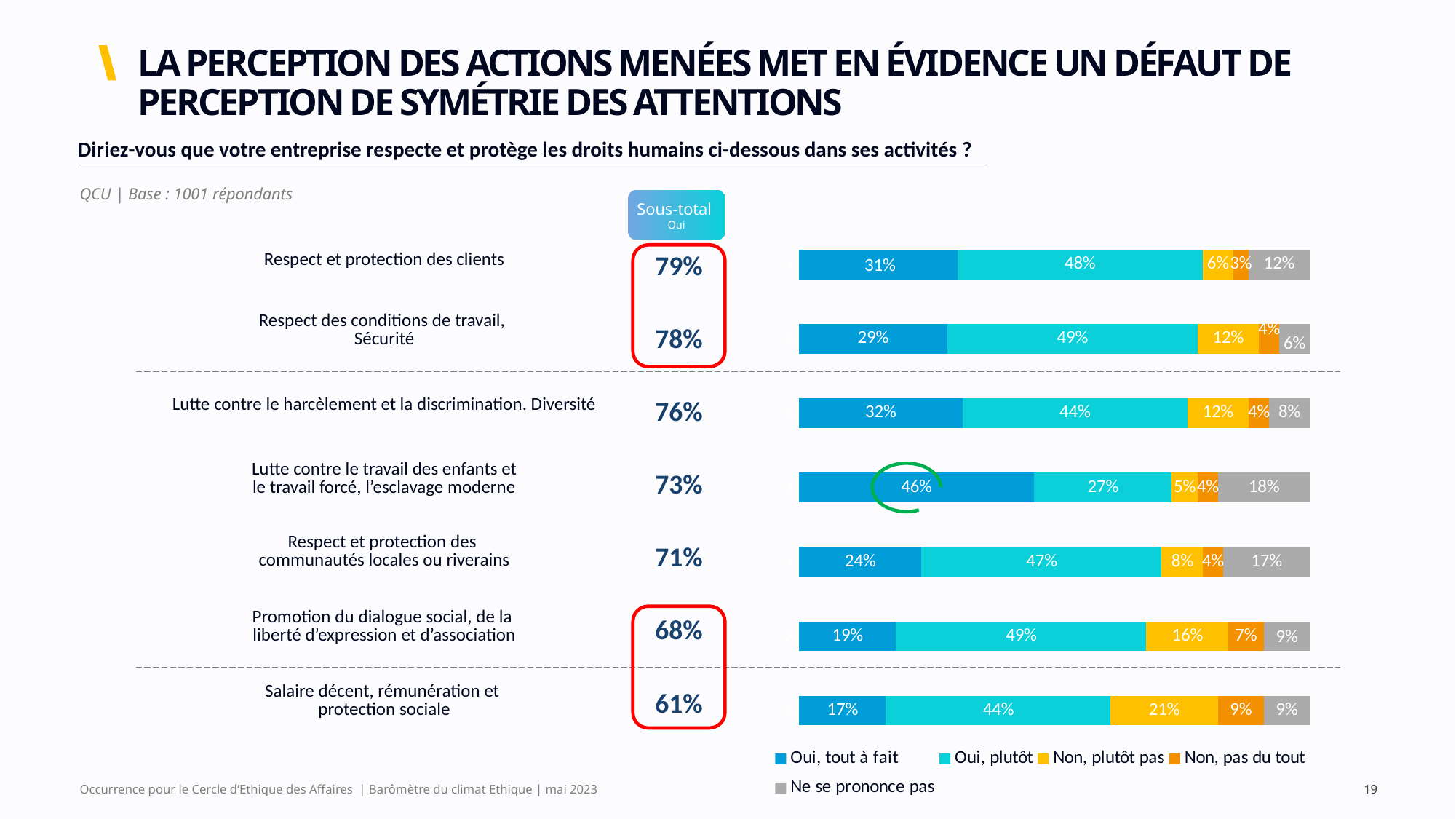
What kind of chart is shown on the slide? Stacked bar chart Which category has the highest 'Oui, tout à fait' value? Lutte contre le travail des enfants et le travail forcé, l'esclavage moderne What is the 'Oui, tout à fait' value for 'Lutte contre le travail des enfants et le travail forcé, l'esclavage moderne'? 46% How many categories (rows) are plotted in the chart? 7 Which is larger: the 'Oui, plutôt' value for 'Respect des conditions de travail, Sécurité' or for 'Lutte contre le harcèlement et la discrimination. Diversité'? Respect des conditions de travail, Sécurité Which category has the lowest 'Sous-total Oui' value? Salaire décent, rémunération et protection sociale What is the 'Sous-total Oui' value for 'Lutte contre le harcèlement et la discrimination. Diversité'? 76% What is the difference between the 'Sous-total Oui' for 'Respect et protection des clients' and for 'Salaire décent, rémunération et protection sociale'? 18 points What is the 'Non, pas du tout' value for 'Promotion du dialogue social, de la liberté d'expression et d'association'? 7% How many series does the legend list? 5 What is the 'Ne se prononce pas' value for 'Respect et protection des communautés locales ou riverains'? 17% What is the 'Non, plutôt pas' value for 'Salaire décent, rémunération et protection sociale'? 21%